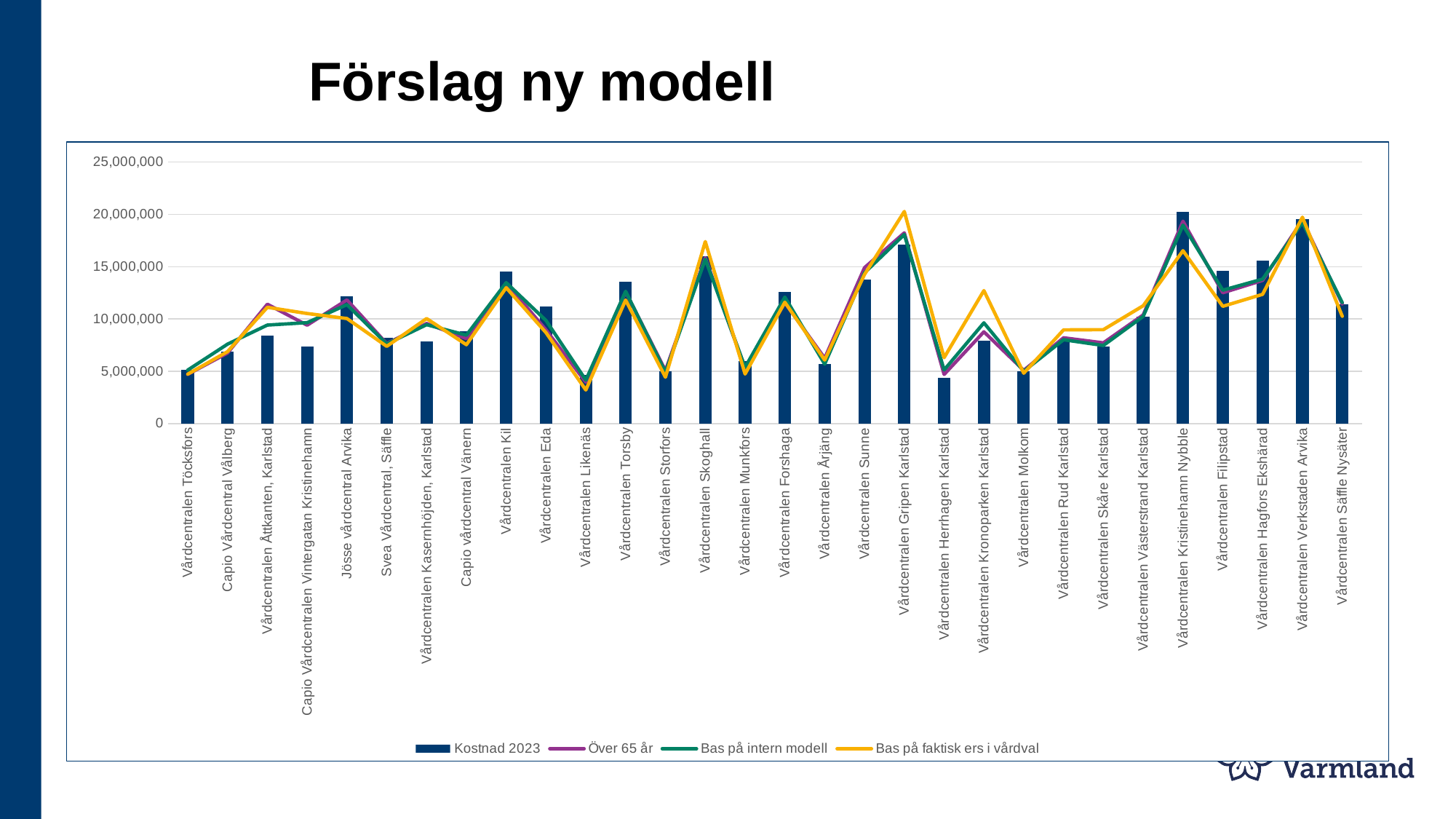
Which has the larger Kostnad 2023 bar, Vårdcentralen Kil or Vårdcentralen Eda? Vårdcentralen Kil What kind of chart is shown on the slide? Combination of a bar chart and line chart Is the Kostnad 2023 value for Capio Vårdcentralen Vintergatan Kristinehamn greater or less than 10,000,000? less Which has the larger Kostnad 2023 bar, Vårdcentralen Torsby or Vårdcentralen Storfors? Vårdcentralen Torsby Is the Kostnad 2023 value for Vårdcentralen Likenäs greater or less than 5,000,000? less Which category has the lowest Kostnad 2023 bar? Vårdcentralen Herrhagen Karlstad What is the title of the chart on the slide? Förslag ny modell Is the Kostnad 2023 value for Vårdcentralen Gripen Karlstad greater or less than 15,000,000? greater Which series is drawn as bars in the chart? Kostnad 2023 Which category has the highest Kostnad 2023 bar? Vårdcentralen Kristinehamn Nybble How many categories (vårdcentraler) are shown along the x axis of the chart? 30 How many series does the chart legend list? 4